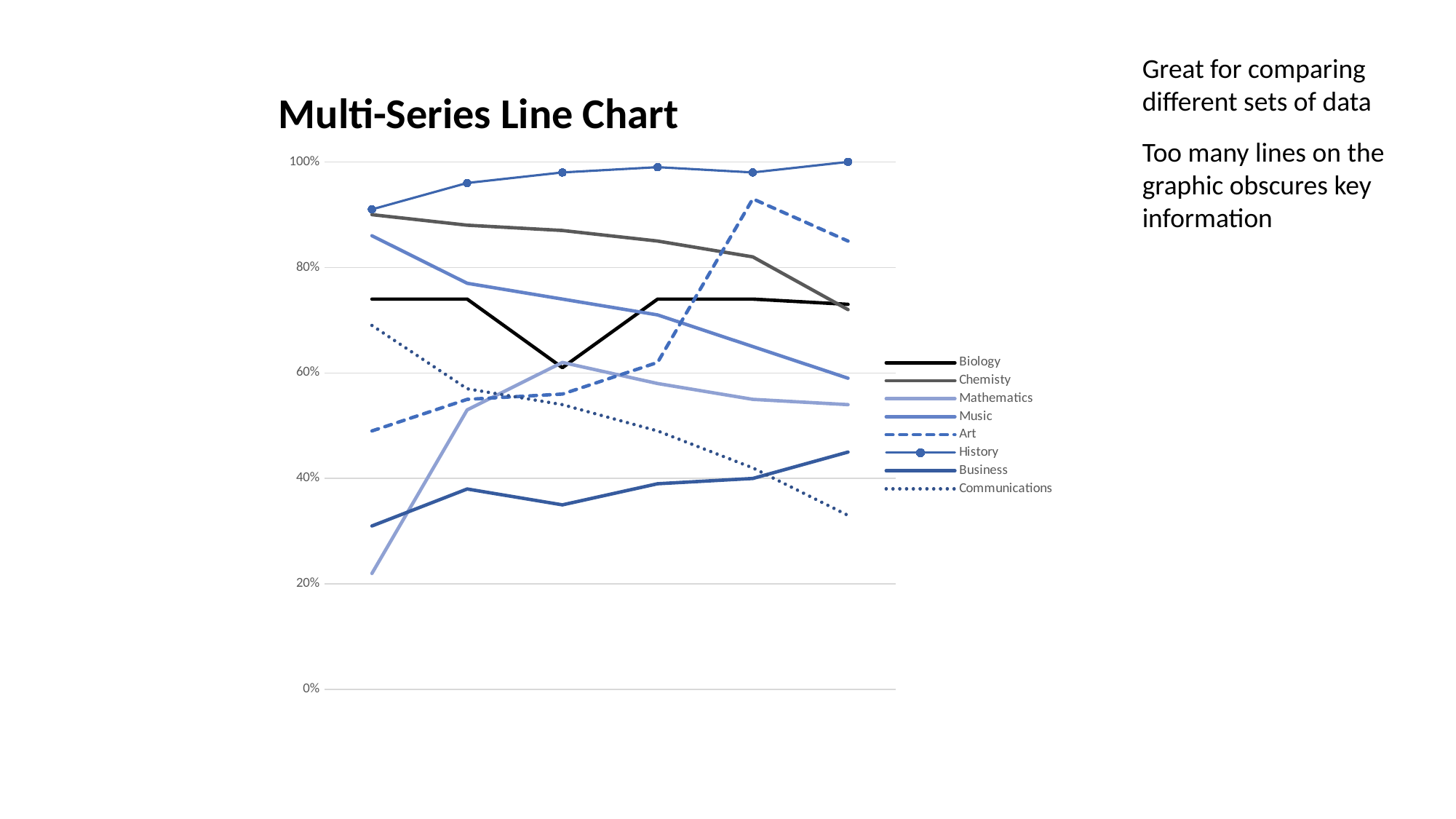
How many data points does the History series have? 6 How many series does the legend list? 8 Does the History series rise or fall from left to right? rise What value does the History series reach at its final point? 100% Which series is drawn with a dotted line? Communications Which series has the highest value at the rightmost point? History At the rightmost point, which is larger, History or Art? History Which series has the lowest value at the leftmost point? Mathematics What kind of chart is shown on the slide? line chart Is the first value of the Business series greater or less than 40%? less What is the title of the chart? Multi-Series Line Chart Does the Communications series rise or fall from left to right? fall